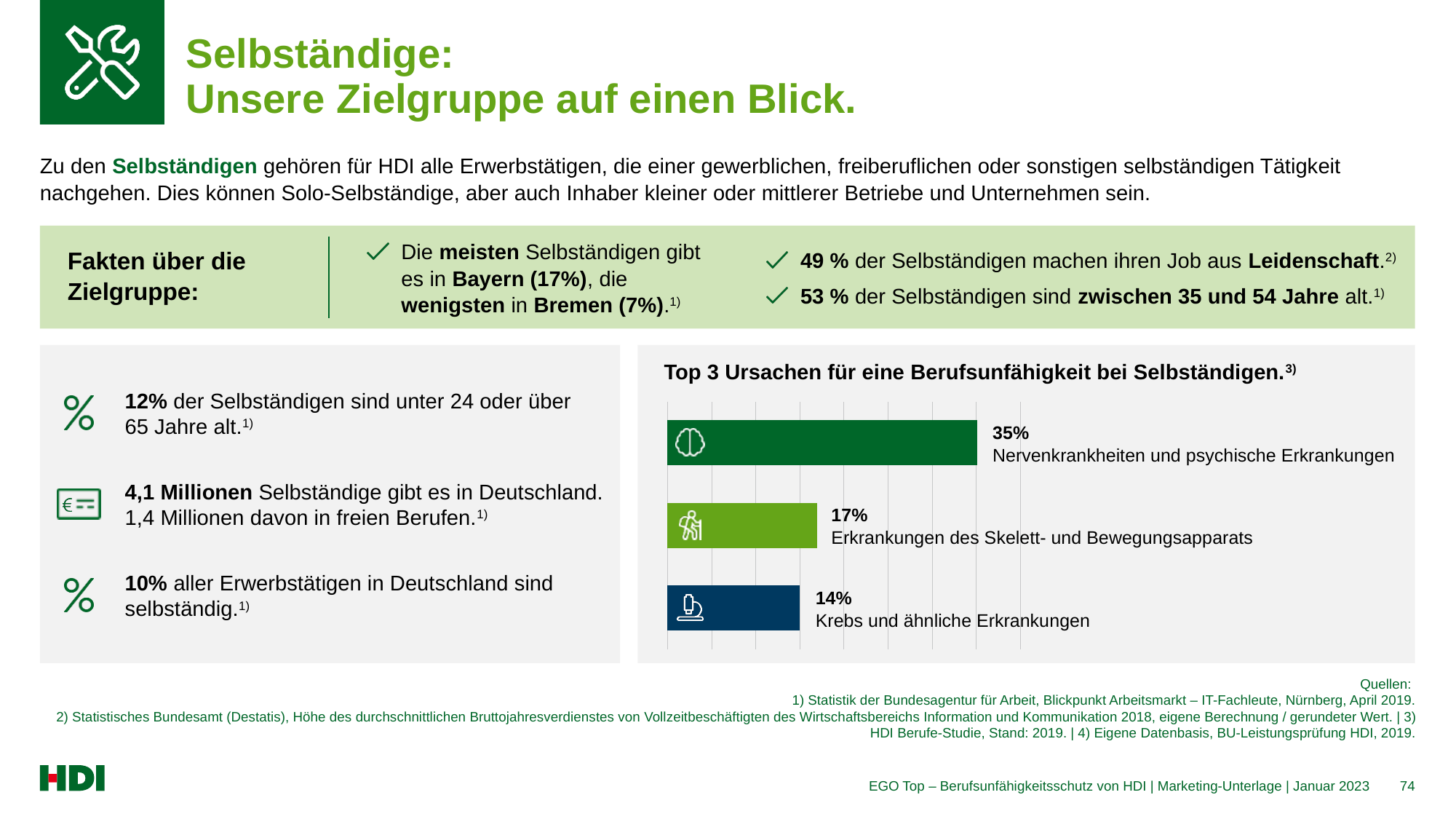
What colour is the bar for Krebs und ähnliche Erkrankungen? Dark blue Which cause has the highest value in the chart? Nervenkrankheiten und psychische Erkrankungen Which is larger: the value for Erkrankungen des Skelett- und Bewegungsapparats or the value for Krebs und ähnliche Erkrankungen? Erkrankungen des Skelett- und Bewegungsapparats What kind of chart is shown on the slide? Bar chart Which cause has the lowest value in the chart? Krebs und ähnliche Erkrankungen What is the title of the chart? Top 3 Ursachen für eine Berufsunfähigkeit bei Selbständigen. What is the value for Nervenkrankheiten und psychische Erkrankungen? 35% What is the difference between the values for Nervenkrankheiten und psychische Erkrankungen and Erkrankungen des Skelett- und Bewegungsapparats? 18% What is the value for Krebs und ähnliche Erkrankungen? 14% How many causes are shown in the chart? 3 What is the value for Erkrankungen des Skelett- und Bewegungsapparats? 17% What is the difference between the values for Erkrankungen des Skelett- und Bewegungsapparats and Krebs und ähnliche Erkrankungen? 3%